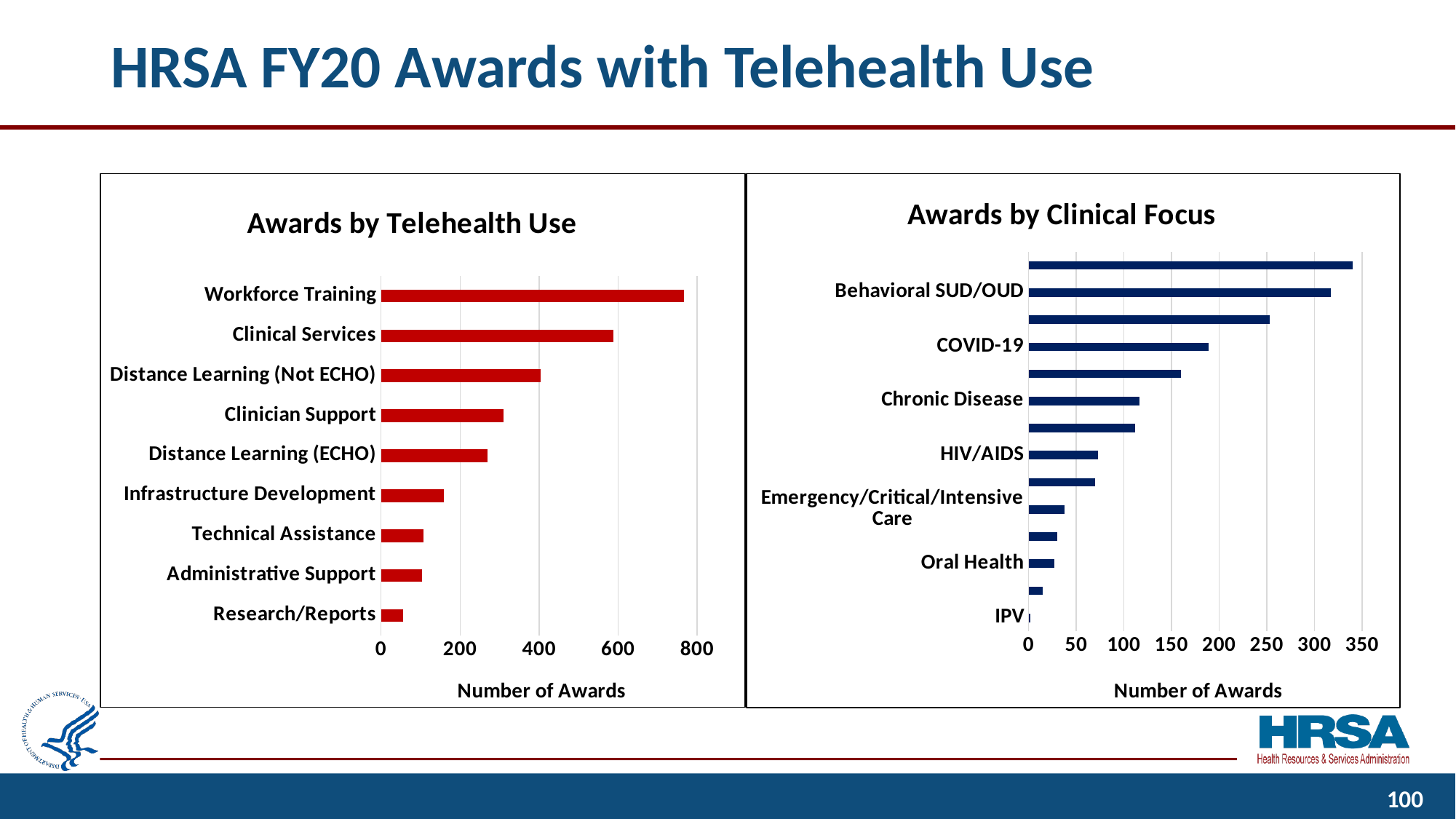
What kind of chart is the "Awards by Telehealth Use" chart? bar chart In the "Awards by Telehealth Use" chart, which category has the lowest number of awards? Research/Reports In the "Awards by Clinical Focus" chart, is the value for Chronic Disease greater or less than 150? less What is the x-axis label of the "Awards by Clinical Focus" chart? Number of Awards In the "Awards by Clinical Focus" chart, which has more awards: COVID-19 or HIV/AIDS? COVID-19 In the "Awards by Clinical Focus" chart, which labeled category has the lowest number of awards? IPV In the "Awards by Telehealth Use" chart, is the value for Workforce Training greater or less than 600? greater In the "Awards by Telehealth Use" chart, which has more awards: Clinical Services or Distance Learning (ECHO)? Clinical Services How many categories are shown in the "Awards by Telehealth Use" chart? 9 In the "Awards by Clinical Focus" chart, is the value for Behavioral SUD/OUD greater or less than 300? greater In the "Awards by Telehealth Use" chart, which category has the highest number of awards? Workforce Training